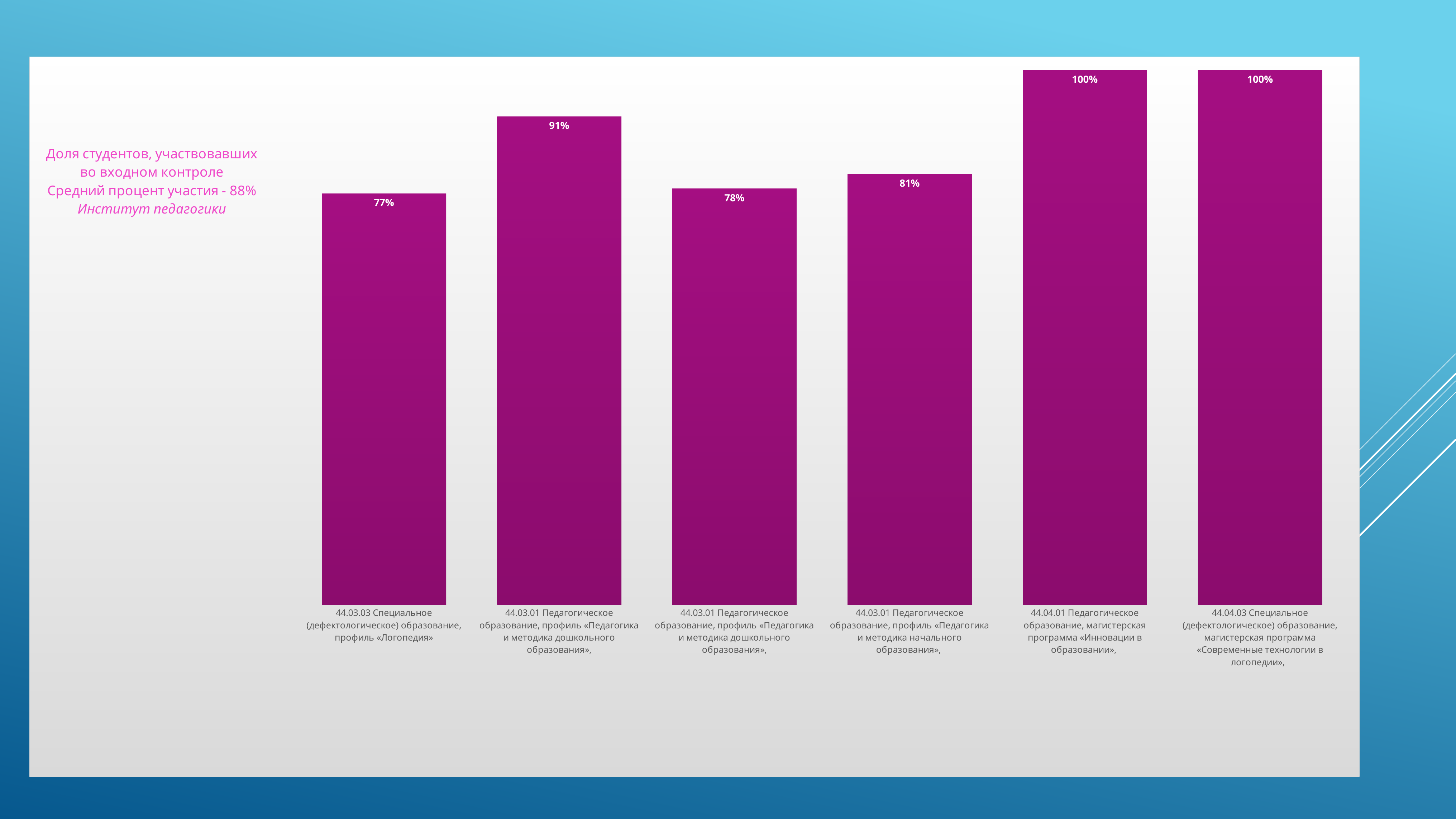
What type of chart is shown on the slide? bar chart Which category has the lowest value? 44.03.03 Специальное (дефектологическое) образование, профиль «Логопедия» According to the text on the slide, what is the average participation percentage (Средний процент участия)? 88% What is the value of the second bar from the left? 91% What is the value of the third bar from the left? 78% Which is larger: the value of the second bar from the left or the value for 44.03.01 Педагогическое образование, профиль «Педагогика и методика начального образования»? the second bar from the left (91%) What is the difference between the value for 44.03.01 Педагогическое образование, профиль «Педагогика и методика начального образования» and the value of the third bar from the left? 3% How many bars (categories) does the chart show? 6 What is the value for 44.03.01 Педагогическое образование, профиль «Педагогика и методика начального образования»? 81% What is the difference between the value for 44.04.03 Специальное (дефектологическое) образование, магистерская программа «Современные технологии в логопедии» and the value for 44.03.03 Специальное (дефектологическое) образование, профиль «Логопедия»? 23% What is the value for 44.04.01 Педагогическое образование, магистерская программа «Инновации в образовании»? 100% What is the value for 44.03.03 Специальное (дефектологическое) образование, профиль «Логопедия»? 77%